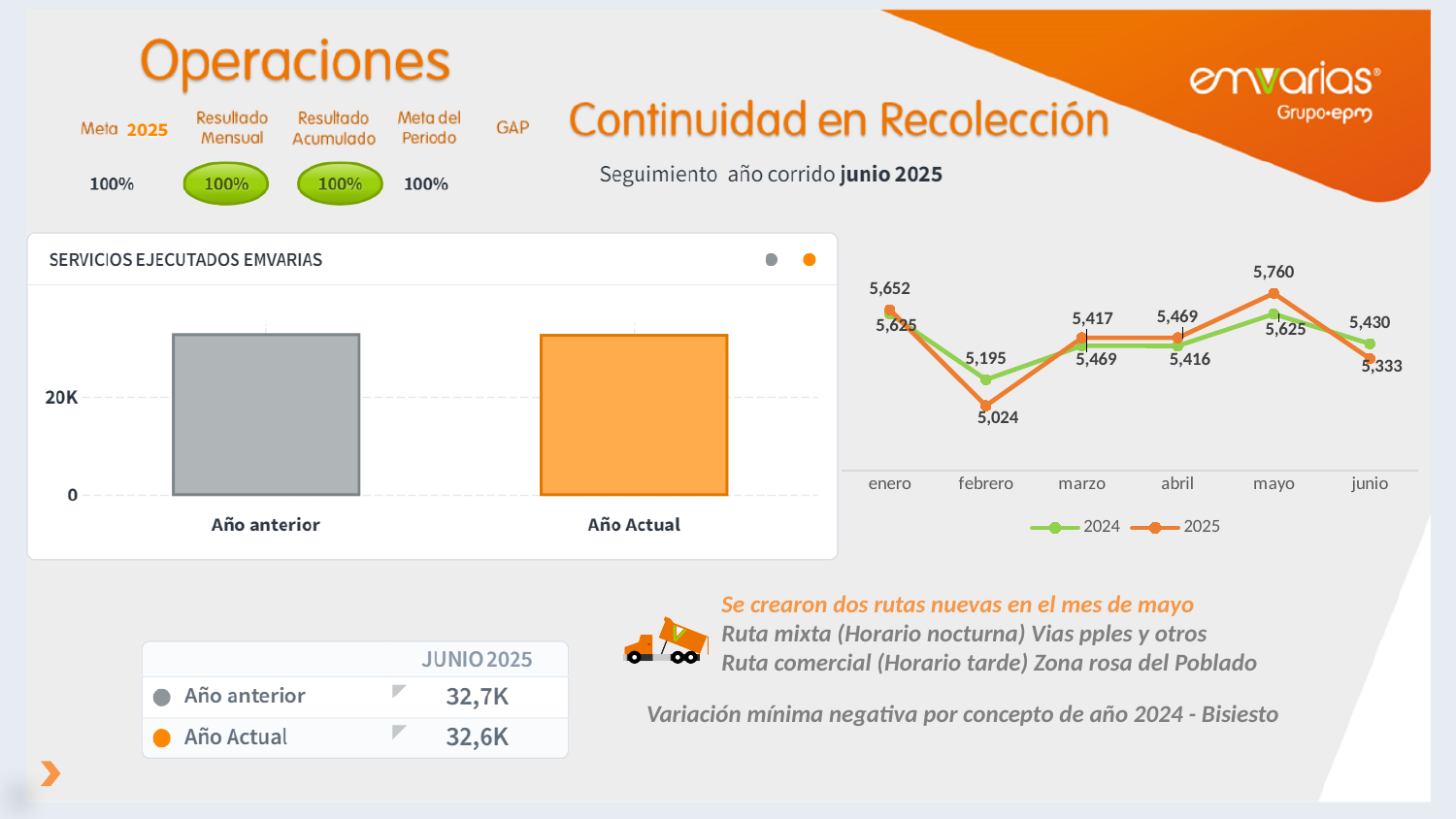
In the chart titled SERVICIOS EJECUTADOS EMVARIAS, is the value for Año anterior greater or less than 20K? greater In the line chart on the right, in which month does the 2025 series reach its highest value? mayo In the line chart on the right, what is the value for 2024 in febrero? 5,195 In the line chart on the right, how many series does the legend list? 2 In the line chart on the right, what is the value for 2025 in febrero? 5,024 In the line chart on the right, what is the value for 2025 in mayo? 5,760 In the line chart on the right, what is the value for 2024 in junio? 5,430 What kind of chart is the chart titled SERVICIOS EJECUTADOS EMVARIAS? bar chart In the line chart on the right, which series has the larger value in febrero, 2024 or 2025? 2024 In the line chart on the right, what is the difference between the 2025 and 2024 values in mayo? 135 In the line chart on the right, does the 2025 series rise or fall from mayo to junio? fall In the line chart on the right, in which month does the 2025 series reach its lowest value? febrero